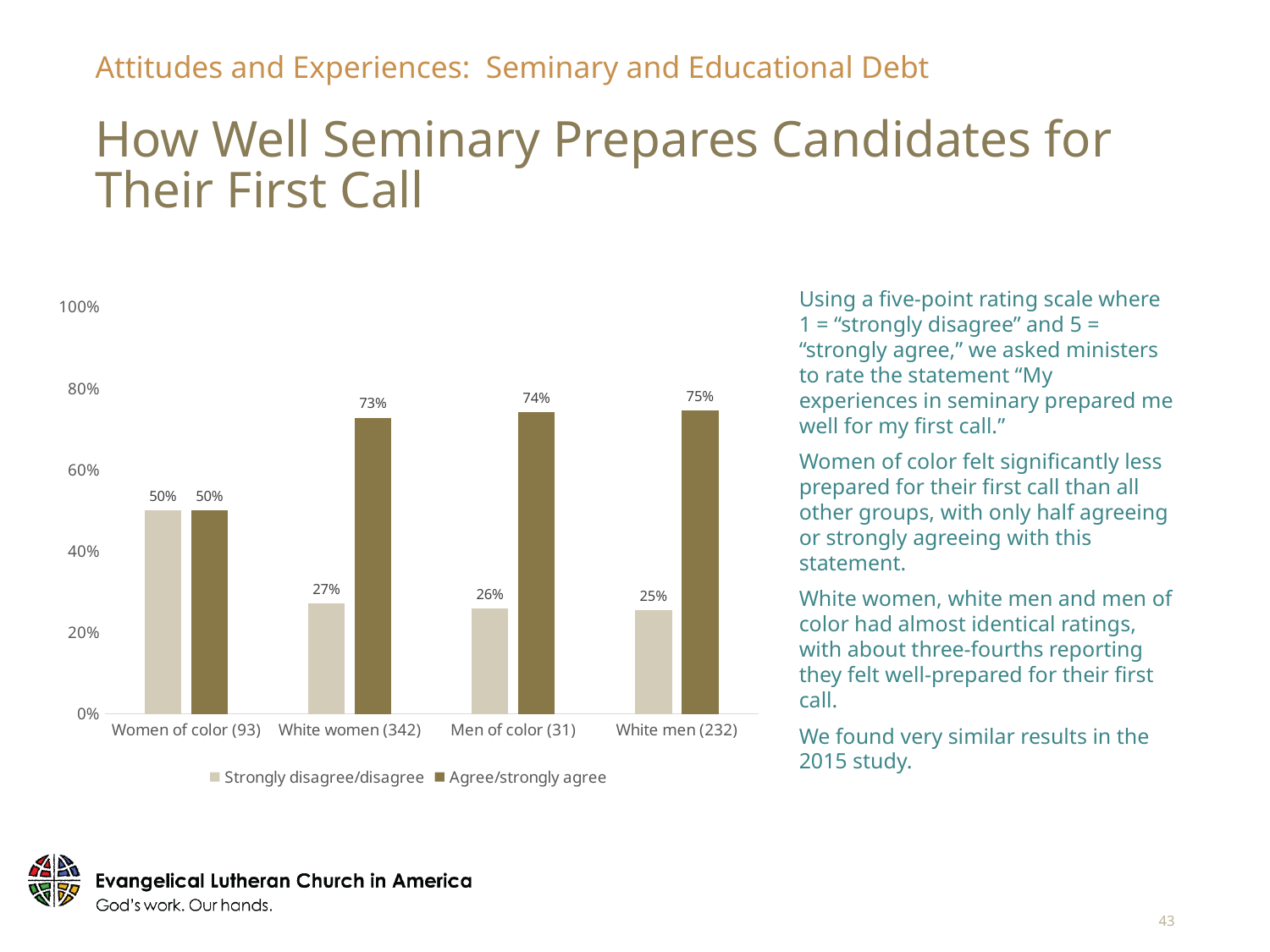
Which group has the highest Agree/strongly agree percentage? White men (232) What are the two legend entries of the chart? Strongly disagree/disagree; Agree/strongly agree Is the Agree/strongly agree value for Men of color greater or less than 60%? greater How many series does the legend list? 2 What percentage of Women of color strongly disagree/disagree? 50% How many groups are shown on the x axis of the chart? 4 What kind of chart is shown on the slide? Bar chart What is the difference between the Agree/strongly agree percentages for White men and Women of color? 25 percentage points What percentage of White women agree/strongly agree that seminary prepared them well for their first call? 73% Which group has the lowest Agree/strongly agree percentage? Women of color (93) What is the Agree/strongly agree value for Men of color? 74% Which is larger: the Strongly disagree/disagree value for White women or for White men? White women